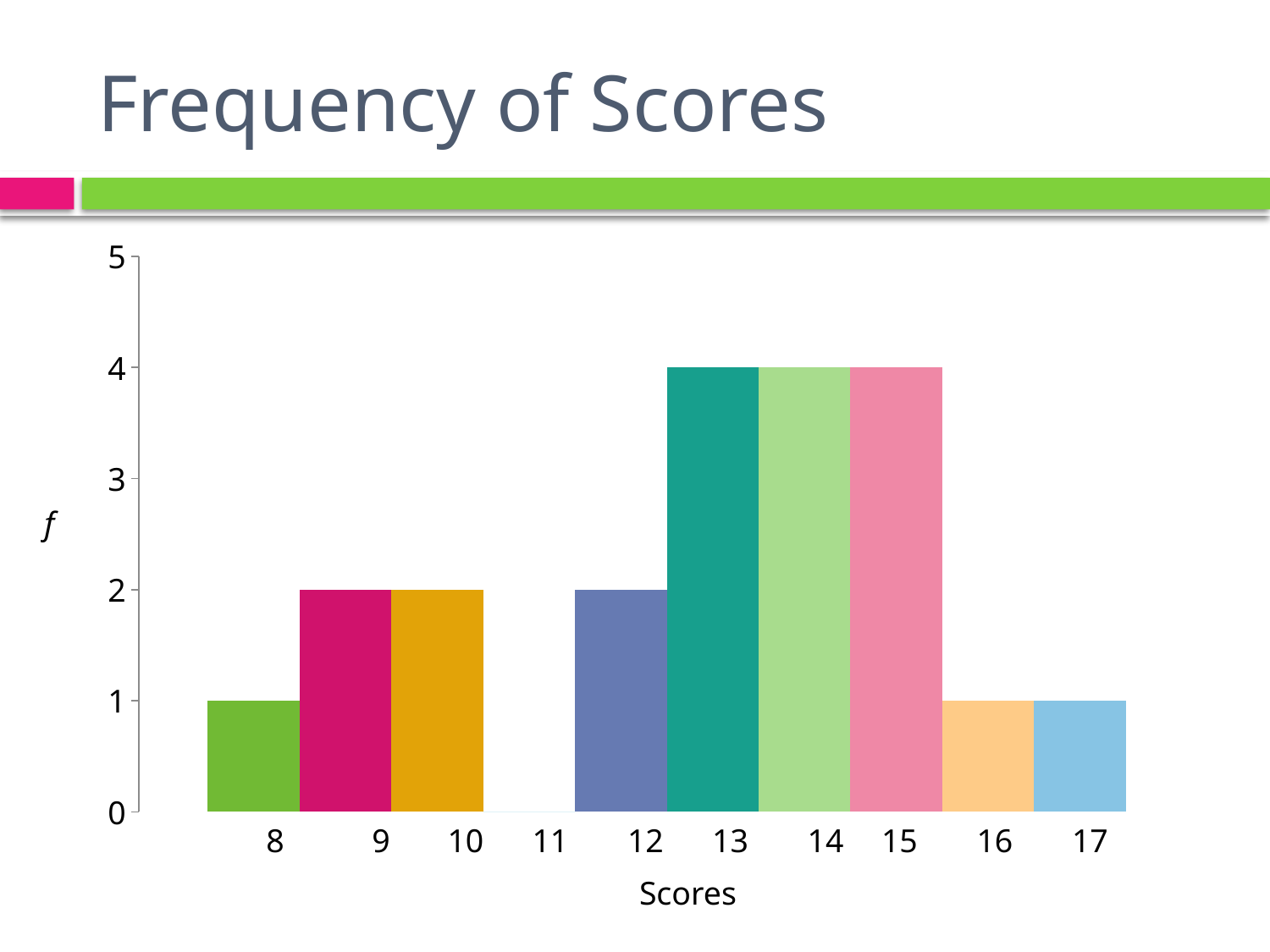
What is the frequency for a score of 16? 1 What kind of chart is shown on the slide? bar chart Which score has the lowest frequency? 11 What is the frequency for a score of 12? 2 What is the frequency for a score of 8? 1 How many score categories are shown on the x axis? 10 What is the frequency for a score of 13? 4 Is the frequency for a score of 15 greater or less than 3? greater What is the label of the x axis? Scores What is the difference between the frequency for a score of 9 and the frequency for a score of 8? 1 What is the difference between the frequency for a score of 13 and the frequency for a score of 12? 2 Which has a higher frequency, a score of 12 or a score of 14? 14